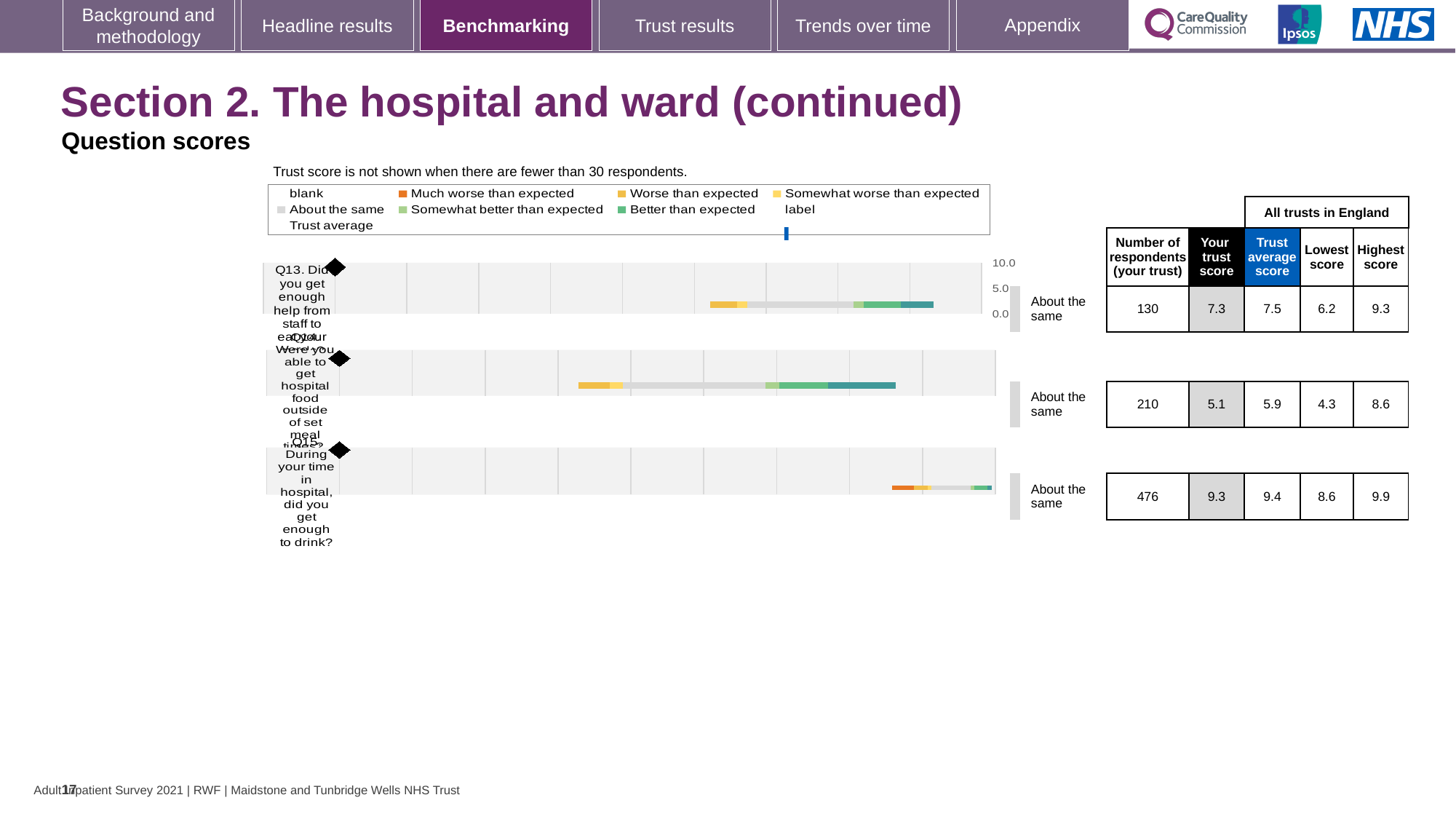
Which question has the lowest number of respondents? Q13 How many questions (Q13, Q14, Q15) are plotted in the question scores chart? 3 What is the 'Your trust score' for Q13 (Did you get enough help from staff to eat your meals?)? 7.3 Which question has the highest 'Your trust score'? Q15 Which has the larger 'Your trust score', Q13 or Q15? Q15 What is the highest score across all trusts in England for Q15 (did you get enough to drink?)? 9.9 What benchmark category is shown next to the Q14 bar? About the same For Q14, what is the difference between the trust average score (5.9) and your trust score (5.1)? 0.8 What is the lowest score across all trusts in England for Q13? 6.2 What kind of chart is used to show the question scores on this slide? bar chart According to the legend, what does the orange colour represent? Much worse than expected What is the number of respondents for Q14 (Were you able to get hospital food outside of set meal times?)? 210